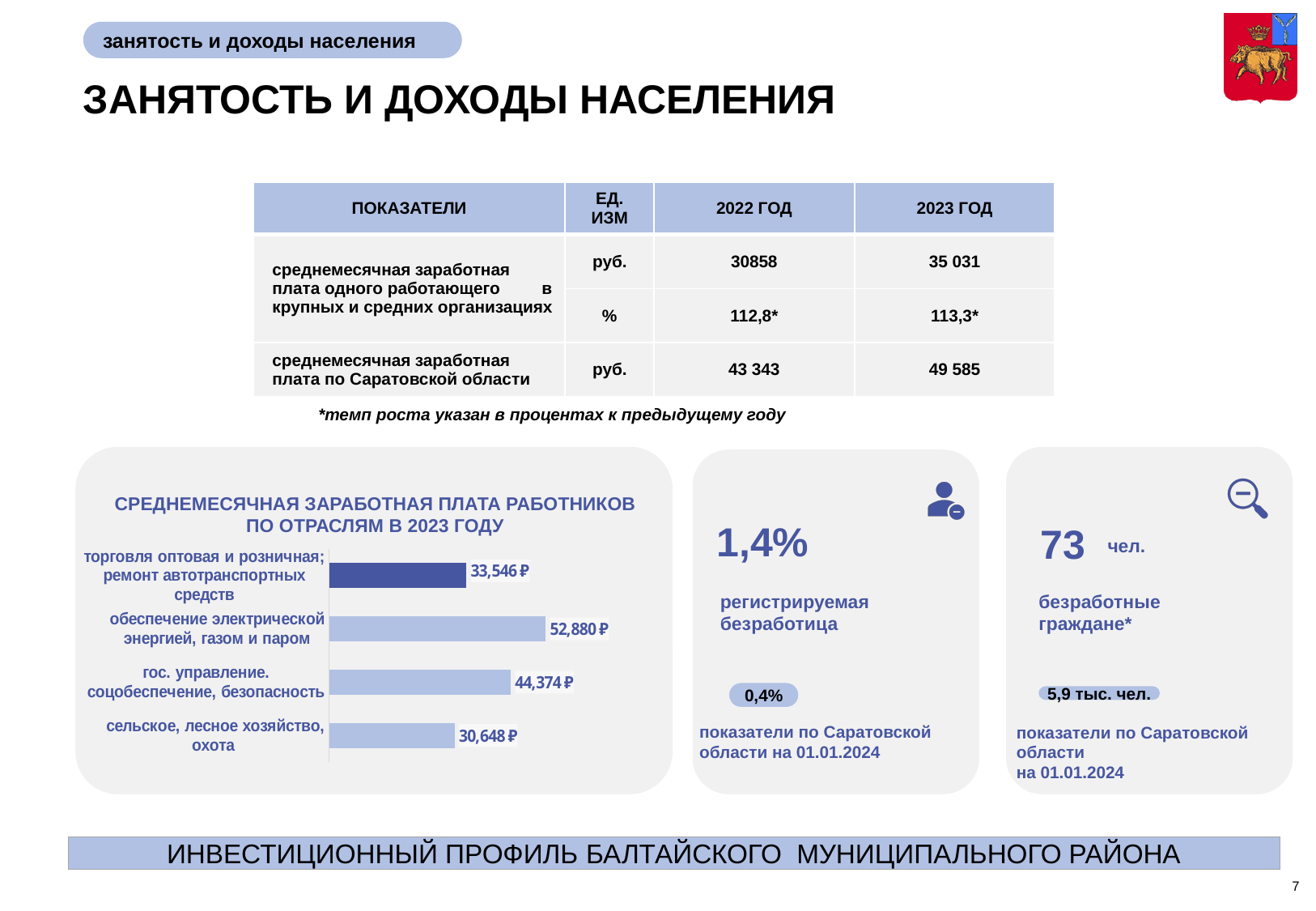
What is the value for 'сельское, лесное хозяйство, охота' in the bar chart? 30,648 ₽ What is the title of the chart on the slide? СРЕДНЕМЕСЯЧНАЯ ЗАРАБОТНАЯ ПЛАТА РАБОТНИКОВ ПО ОТРАСЛЯМ В 2023 ГОДУ What is the difference between the salary for 'обеспечение электрической энергией, газом и паром' and 'сельское, лесное хозяйство, охота' in the bar chart? 22,232 ₽ What is the difference between the salary for 'гос. управление. соцобеспечение, безопасность' and 'торговля оптовая и розничная; ремонт автотранспортных средств' in the bar chart? 10,828 ₽ What is the value for 'гос. управление. соцобеспечение, безопасность' in the bar chart? 44,374 ₽ Which sector has the lowest average monthly salary in the bar chart? сельское, лесное хозяйство, охота What type of chart is used to show average monthly salary by sector? bar chart Which sector has the highest average monthly salary in the bar chart? обеспечение электрической энергией, газом и паром How many sectors are shown in the bar chart? 4 In the bar chart, which is larger: the salary for 'гос. управление. соцобеспечение, безопасность' or for 'торговля оптовая и розничная; ремонт автотранспортных средств'? гос. управление. соцобеспечение, безопасность What is the average monthly salary shown for 'торговля оптовая и розничная; ремонт автотранспортных средств' in the bar chart? 33,546 ₽ What value does the bar chart show for 'обеспечение электрической энергией, газом и паром'? 52,880 ₽